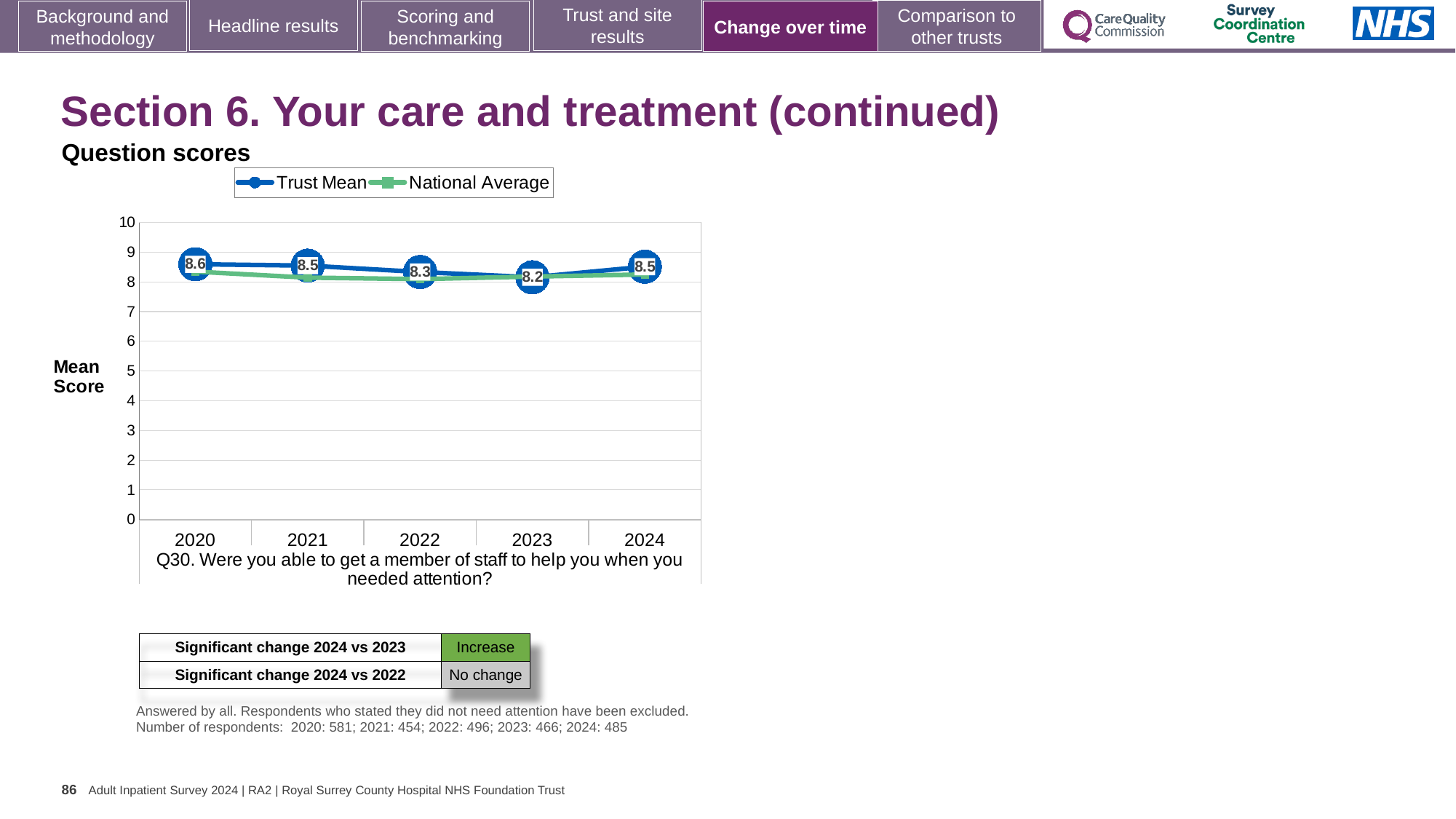
How many years are plotted on the x axis? 5 Does the Trust Mean rise or fall from 2020 to 2023? Fall What is the Trust Mean score for 2024? 8.5 What is the Trust Mean score for 2020? 8.6 Is the National Average value for 2020 greater or less than 7? greater Which year has the larger Trust Mean, 2021 or 2022? 2021 What kind of chart is shown? Line chart What is the Trust Mean score for 2023? 8.2 In which year is the Trust Mean highest? 2020 In which year is the Trust Mean lowest? 2023 How many series does the legend list? 2 What is the difference between the Trust Mean in 2020 and in 2023? 0.4